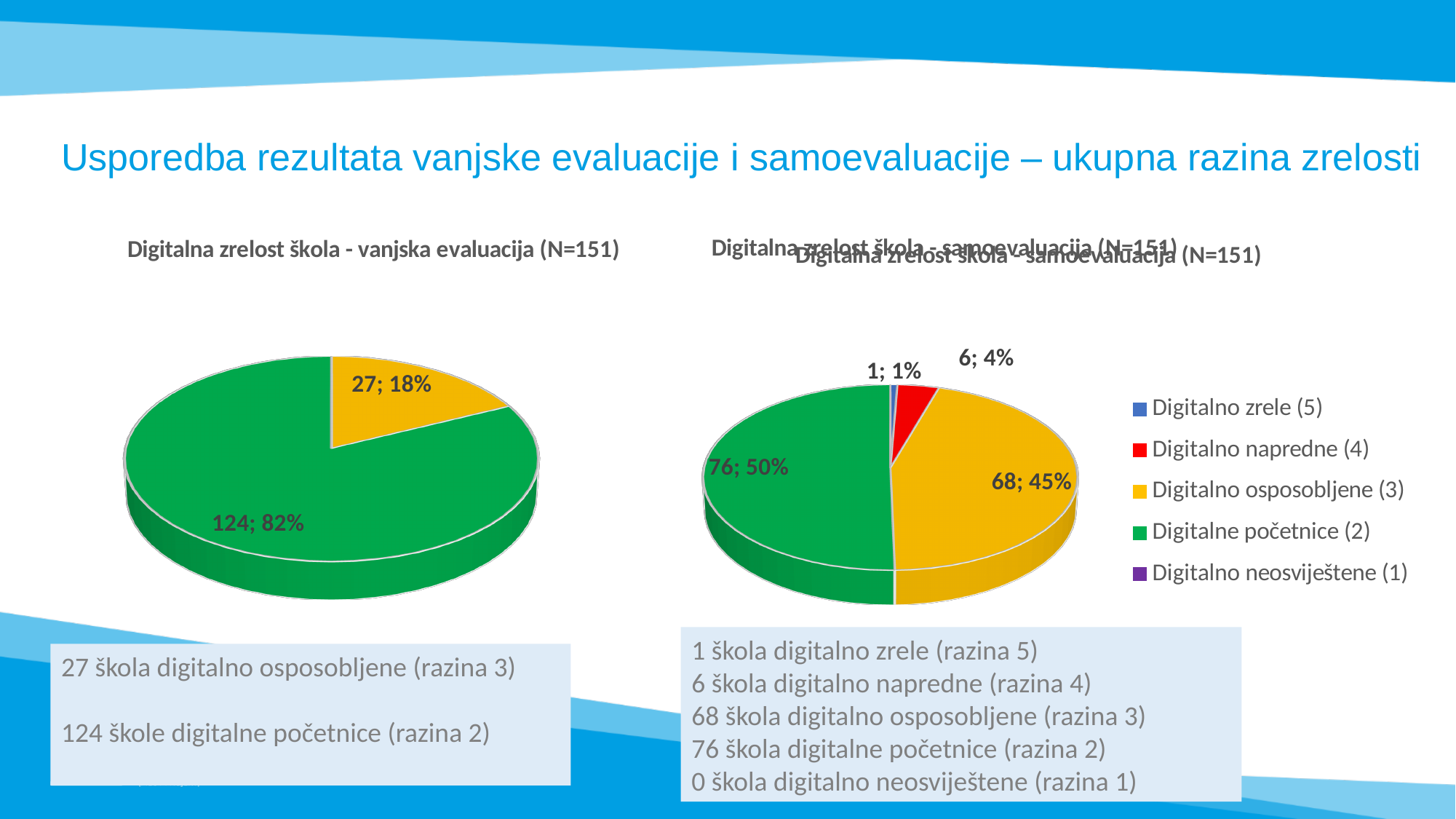
In the chart titled "Digitalna zrelost škola - samoevaluacija (N=151)", which category has the largest slice? Digitalne početnice (2) In the chart titled "Digitalna zrelost škola - samoevaluacija (N=151)", what colour represents Digitalno napredne (4)? Red In the chart titled "Digitalna zrelost škola - samoevaluacija (N=151)", what percentage share do the digitalne početnice (2) schools have? 50% In the chart titled "Digitalna zrelost škola - samoevaluacija (N=151)", how many schools are digitalno osposobljene (3)? 68 What type of chart is used on this slide? Pie chart In the chart titled "Digitalna zrelost škola - vanjska evaluacija (N=151)", what is the difference between the number of digitalne početnice (razina 2) schools and digitalno osposobljene (razina 3) schools? 97 In the chart titled "Digitalna zrelost škola - samoevaluacija (N=151)", which category has the smallest non-zero slice? Digitalno zrele (5) In the chart titled "Digitalna zrelost škola - vanjska evaluacija (N=151)", what percentage share do the digitalno osposobljene (razina 3) schools have? 18% In the chart titled "Digitalna zrelost škola - vanjska evaluacija (N=151)", how many schools are digitalne početnice (razina 2)? 124 Which chart shows more digitalno osposobljene schools: the vanjska evaluacija chart or the samoevaluacija chart? samoevaluacija How many entries does the legend of the chart titled "Digitalna zrelost škola - samoevaluacija (N=151)" list? 5 In the chart titled "Digitalna zrelost škola - samoevaluacija (N=151)", what is the difference between the number of digitalne početnice (2) schools and digitalno osposobljene (3) schools? 8